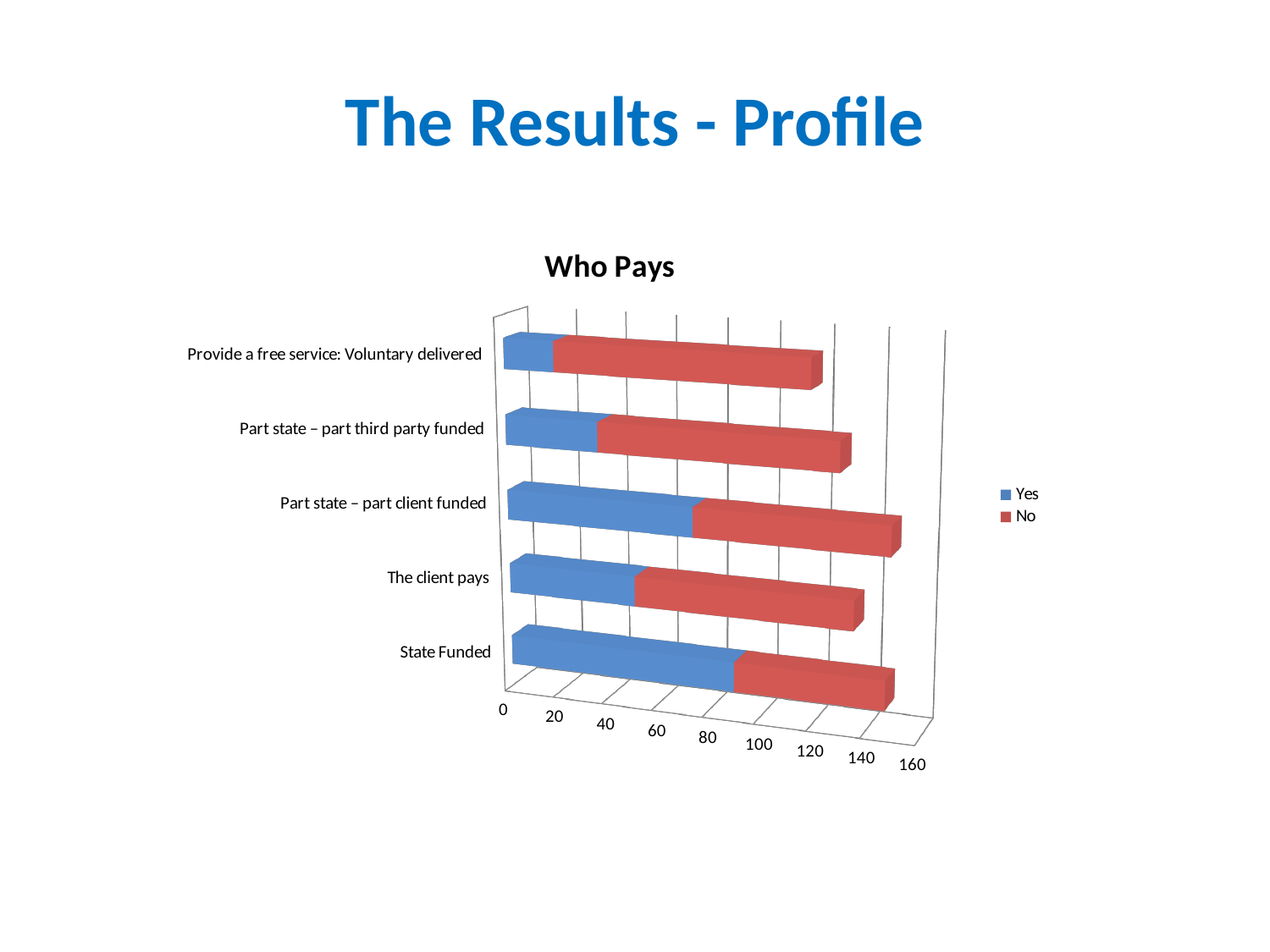
Which category has the smallest Yes value in the Who Pays chart? Provide a free service: Voluntary delivered Is the Yes value for Part state – part client funded greater or less than 40? greater Which has the larger No value: Provide a free service: Voluntary delivered or The client pays? Provide a free service: Voluntary delivered Is the Yes value for Provide a free service: Voluntary delivered greater or less than 60? less How many series does the legend of the Who Pays chart list? 2 How many categories are shown in the Who Pays chart? 5 Which category has the largest Yes value in the Who Pays chart? State Funded Is the Yes value for State Funded greater or less than 60? greater What kind of chart is shown on the slide? bar chart Which has the larger Yes value: State Funded or Provide a free service: Voluntary delivered? State Funded What is the title of the chart? Who Pays Which series is shown in blue in the Who Pays chart? Yes